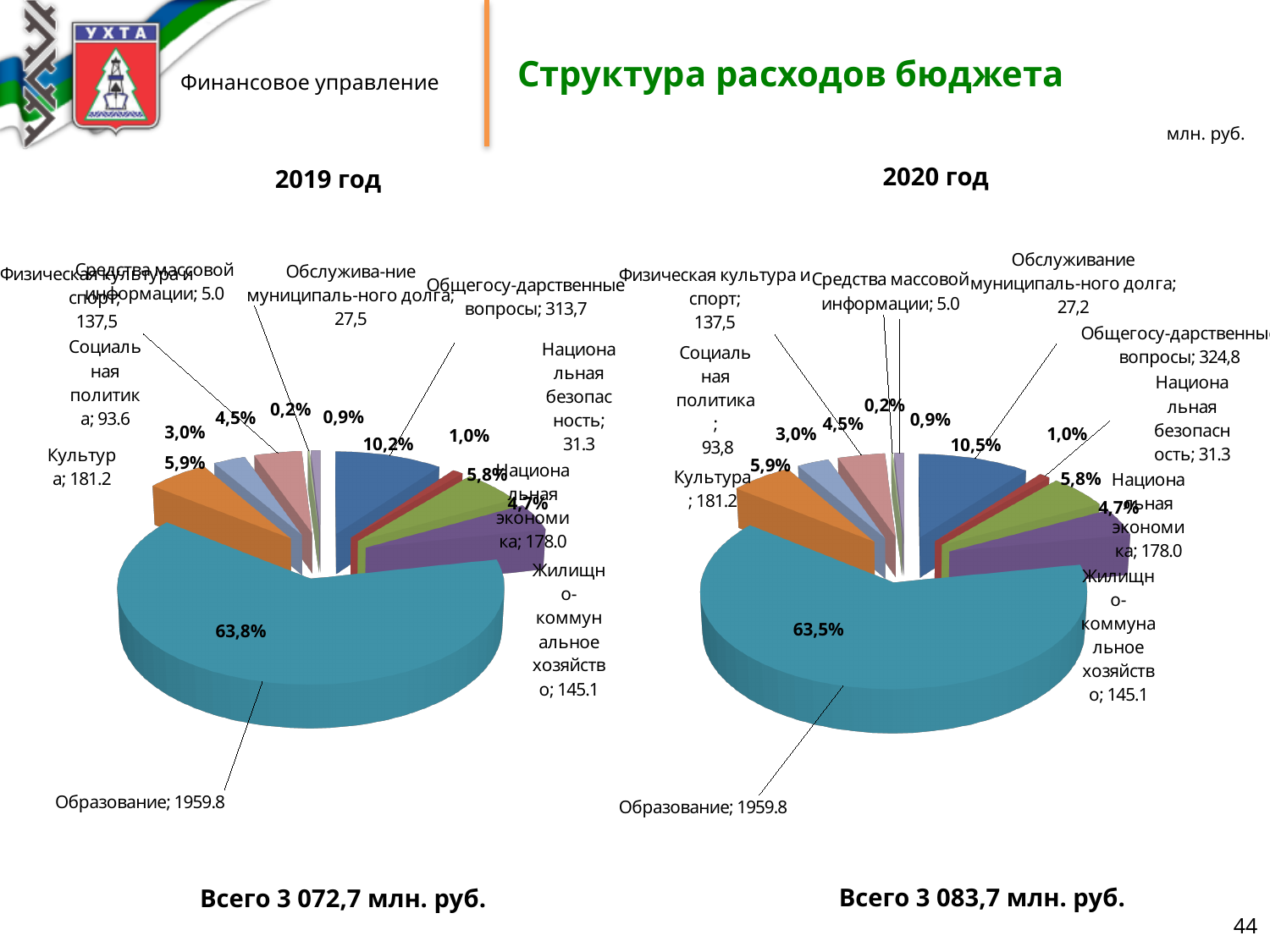
In the 2020 год chart, what is the value for Общегосударственные вопросы? 324,8 In the 2019 год chart, what share of the pie does Образование take? 63,8% In the 2019 год chart, what is the value for Образование? 1959.8 In the 2020 год chart, which is larger: Национальная экономика or Физическая культура и спорт? Национальная экономика In the 2019 год chart, what is the difference between Культура (181.2) and Жилищно-коммунальное хозяйство (145.1)? 36.1 How many categories are shown in the 2020 год chart? 10 What kind of chart is used for the 2019 год chart? pie chart In the 2019 год chart, which category has the smallest value? Средства массовой информации In the 2020 год chart, what share of the pie does Общегосударственные вопросы take? 10,5% In the 2020 год chart, what is the value for Обслуживание муниципального долга? 27,2 What is the total shown below the 2019 год chart? 3 072,7 млн. руб. In the 2020 год chart, which category has the largest value? Образование